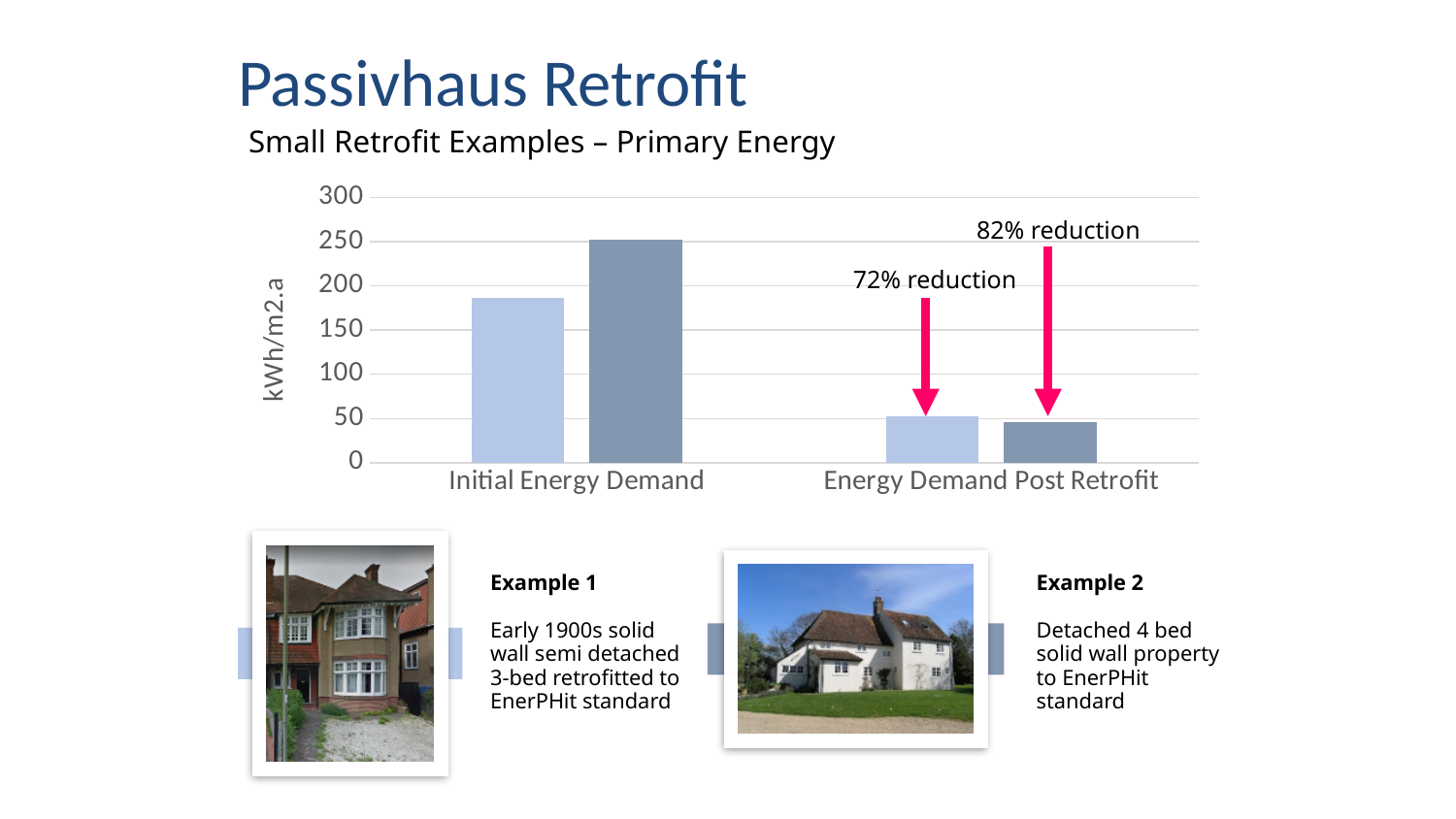
What percentage reduction is labelled above the darker blue bar in the Energy Demand Post Retrofit category? 82% reduction Which category contains the tallest bar in the chart? Initial Energy Demand Is the value of the darker blue bar for Initial Energy Demand greater or less than 200? greater Is the value of the lighter blue bar for Energy Demand Post Retrofit greater or less than 100? less How many categories are shown on the x axis of the chart? 2 What kind of chart is shown on the slide? Bar chart What is the label on the vertical axis of the chart? kWh/m2.a What percentage reduction is labelled above the lighter blue bar in the Energy Demand Post Retrofit category? 72% reduction Is the value of the lighter blue bar for Initial Energy Demand greater or less than 150? greater How many bars are plotted in the chart? 4 In the Initial Energy Demand category, which bar is taller, the lighter blue or the darker blue? The darker blue bar Do the bar values rise or fall from Initial Energy Demand to Energy Demand Post Retrofit? Fall